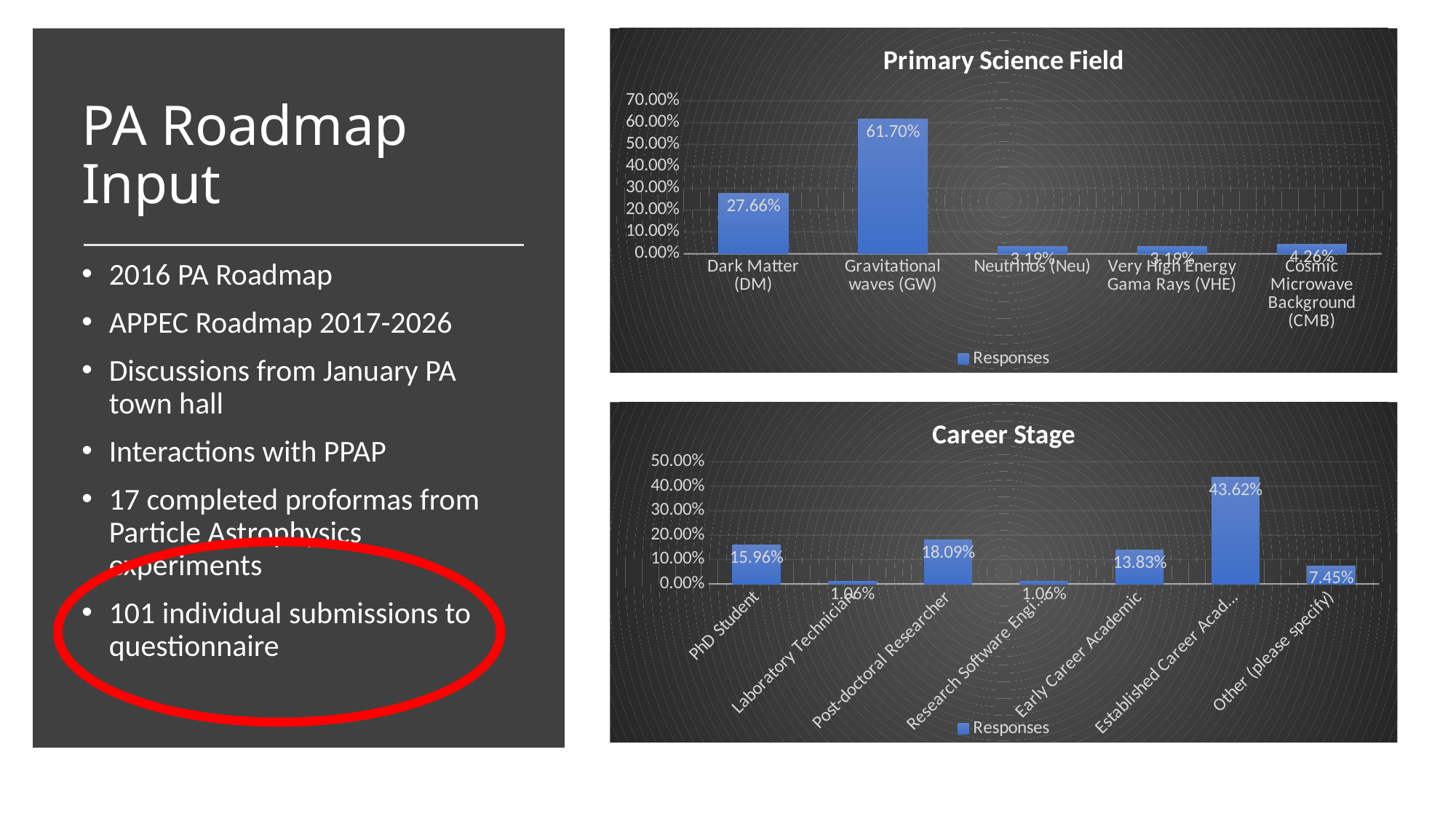
In the Career Stage chart, what is the value for Established Career Acad...? 43.62% In the Primary Science Field chart, is the value for Cosmic Microwave Background (CMB) greater or less than 10.00%? less In the Primary Science Field chart, how many categories are shown on the x axis? 5 In the Primary Science Field chart, what is the value for Dark Matter (DM)? 27.66% In the Career Stage chart, which is larger, the value for PhD Student or the value for Early Career Academic? PhD Student What type of chart is the Career Stage chart? Bar chart In the Primary Science Field chart, what is the value for Gravitational waves (GW)? 61.70% In the Career Stage chart, which category has the highest value? Established Career Acad... In the Primary Science Field chart, what is the difference between the values for Gravitational waves (GW) and Dark Matter (DM)? 34.04% In the Career Stage chart, what is the difference between the values for PhD Student and Early Career Academic? 2.13% In the Primary Science Field chart, which category has the highest value? Gravitational waves (GW) In the Career Stage chart, what is the value for Post-doctoral Researcher? 18.09%